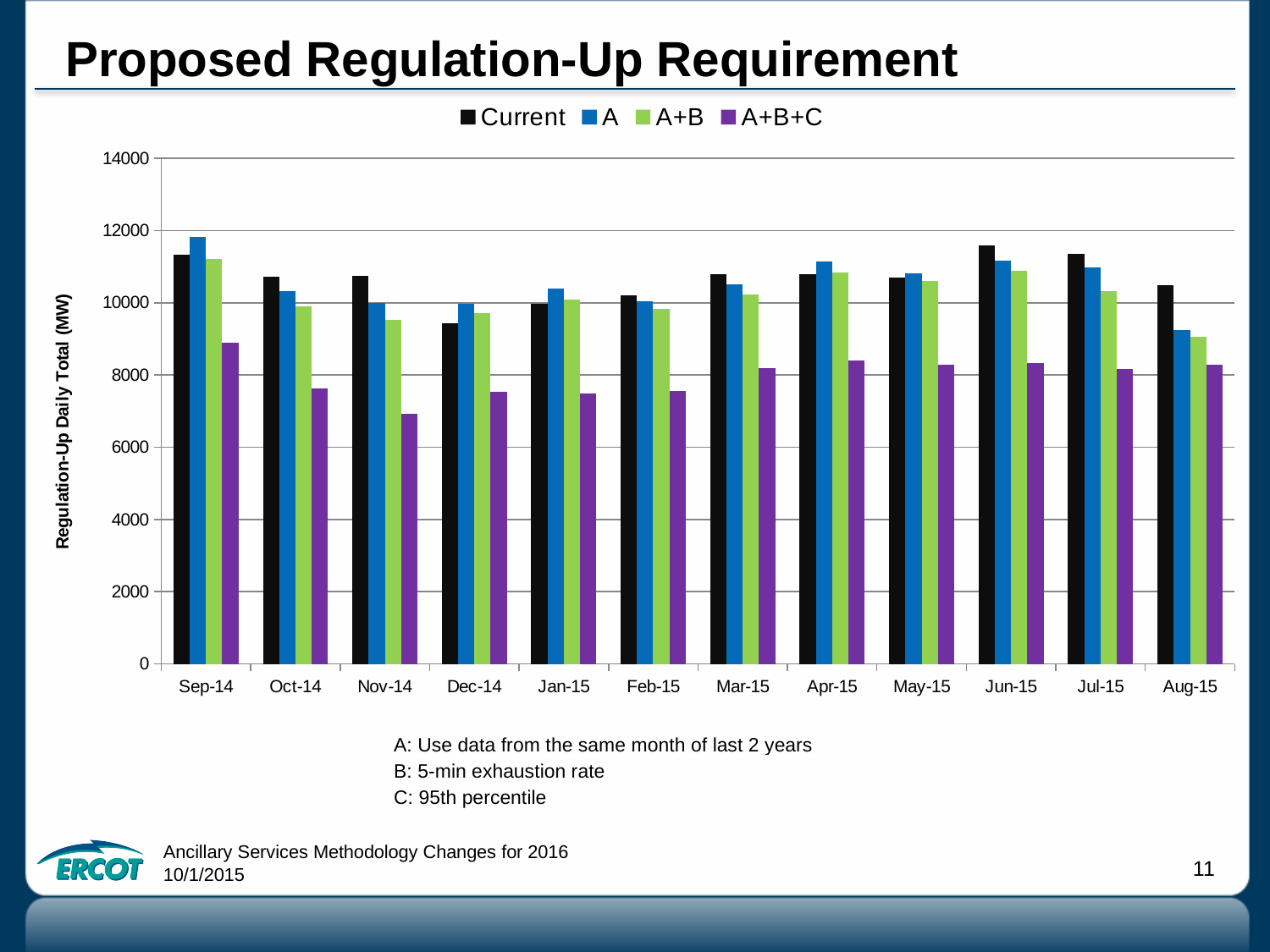
Is the Current value for Jun-15 greater or less than 11000? greater Which month has the lowest A+B+C value? Nov-14 How many series does the legend list? 4 What kind of chart is shown on the slide? Bar chart Is the A+B+C value for Sep-14 greater or less than 8000? greater In Aug-15, which is larger: the Current value or the A value? Current How many months are shown along the x axis? 12 Which month has the highest A value? Sep-14 Which month has the lowest Current value? Dec-14 Is the A+B+C value for Nov-14 greater or less than 8000? less In Dec-14, which is larger: the Current value or the A value? A What is the title of the y axis? Regulation-Up Daily Total (MW)